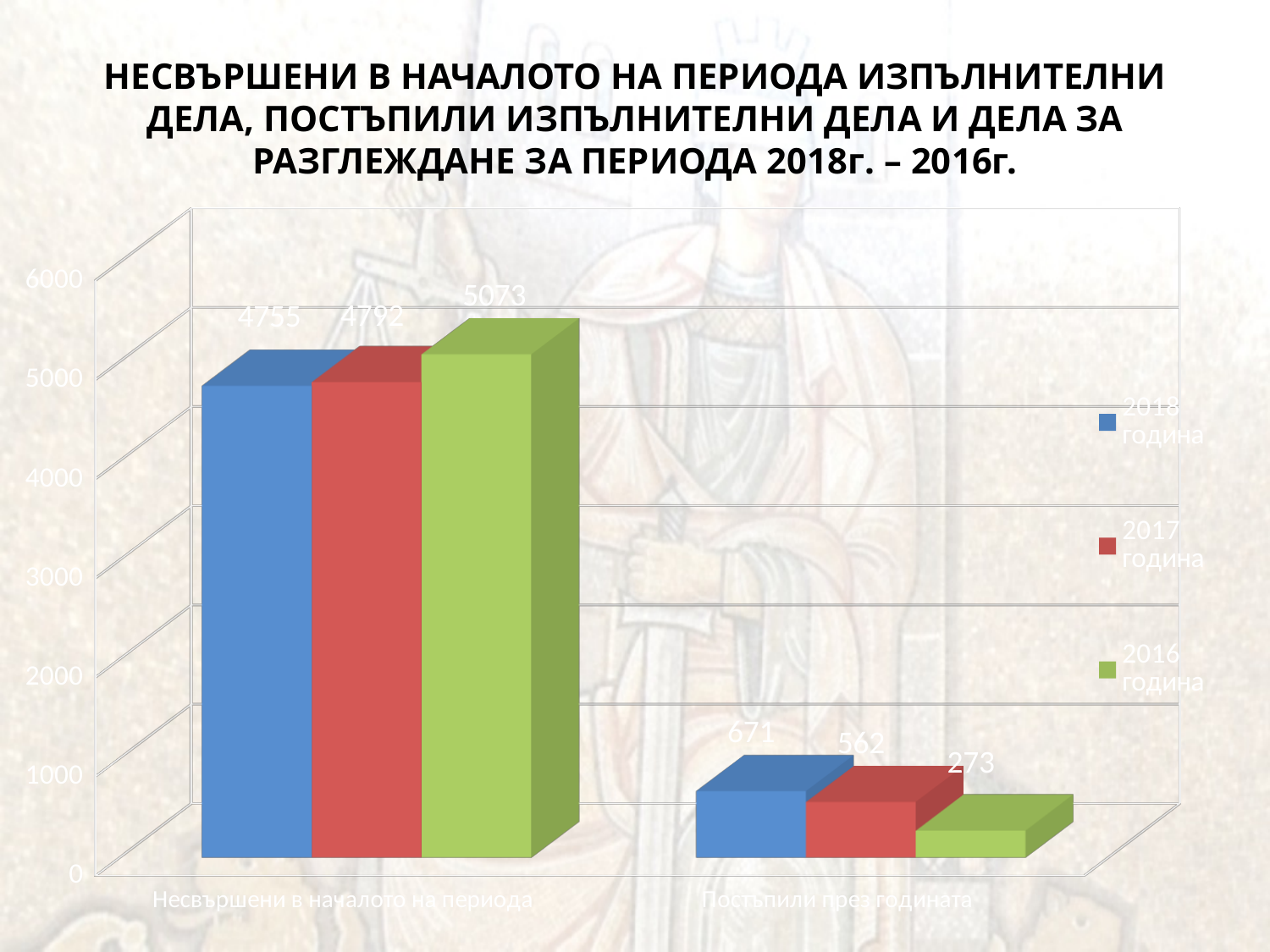
Which year has the highest value in the category Несвършени в началото на периода? 2016 година What is the difference between the 2018 година and 2016 година values in the category Постъпили през годината? 398 How many categories are shown on the x axis? 2 What is the value for 2016 година in the category Несвършени в началото на периода? 5073 What is the value for 2018 година in the category Постъпили през годината? 671 Which year has the lowest value in the category Постъпили през годината? 2016 година What is the value for 2017 година in the category Несвършени в началото на периода? 4792 Which is larger in the category Постъпили през годината: the value for 2018 година or for 2017 година? 2018 година Is the value for 2016 година in the category Несвършени в началото на периода greater or less than 5000? greater How many series does the legend list? 3 What type of chart is shown on the slide? bar chart Which colour represents 2017 година in the chart? red